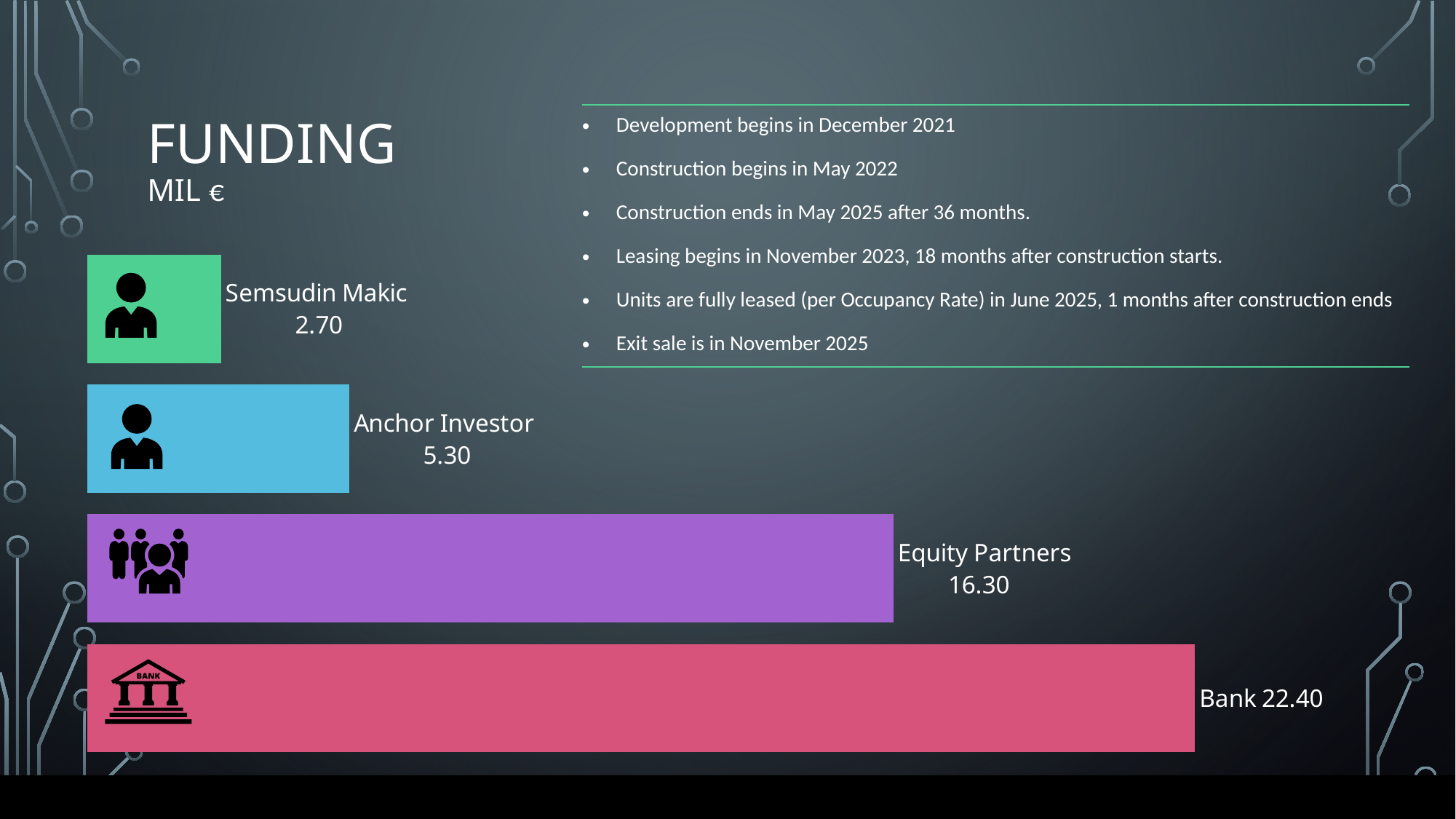
What is the funding value for Bank? 22.40 Which is larger, the funding from Equity Partners or from Anchor Investor? Equity Partners What is the funding value for Equity Partners? 16.30 Which funding source has the highest value? Bank What kind of chart is used to show the funding? Bar chart What is the funding value for Semsudin Makic? 2.70 What is the difference between the Anchor Investor and Semsudin Makic funding values? 2.60 What unit is stated under the chart title FUNDING? MIL € How many funding sources are shown in the chart? 4 What is the difference between the Bank and Equity Partners funding values? 6.10 Which funding source has the lowest value? Semsudin Makic What is the funding value for Anchor Investor? 5.30